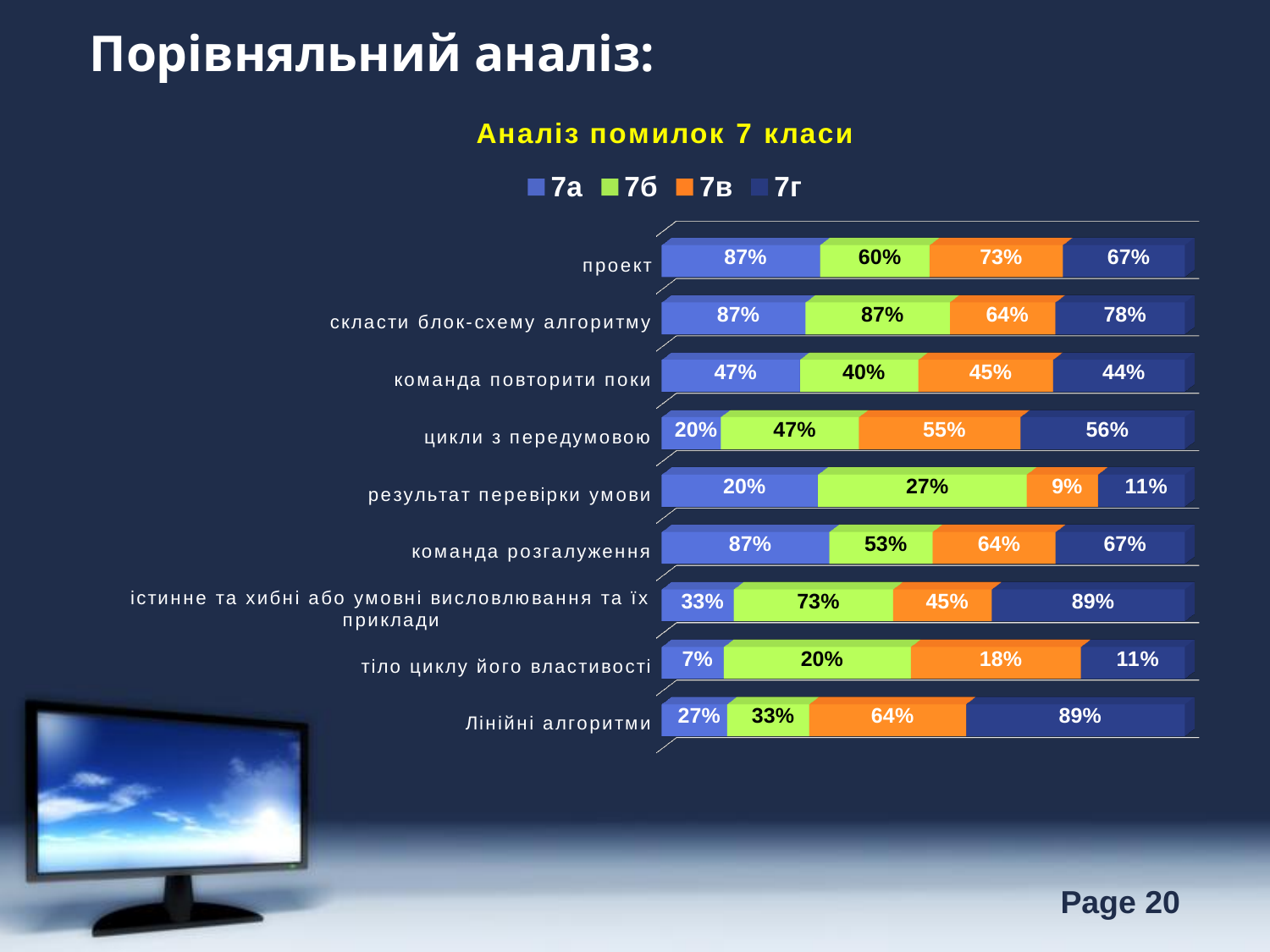
What type of chart is shown on the slide? stacked bar chart What is the value for 7г in the category 'Лінійні алгоритми'? 89% What is the value for 7б in the category 'істинне та хибні або умовні висловлювання та їх приклади'? 73% What is the value for 7в in the category 'результат перевірки умови'? 9% What is the value for 7а in the category 'проект'? 87% What is the title of the chart? Аналіз помилок 7 класи Which series has the highest value in the category 'цикли з передумовою'? 7г In the category 'скласти блок-схему алгоритму', which is larger: the value for 7в or the value for 7г? 7г Which series has the lowest value in the category 'тіло циклу його властивості'? 7а How many series does the legend list? 4 How many categories are shown on the chart? 9 What is the difference between the 7а and 7б values in the category 'команда розгалуження'? 34%